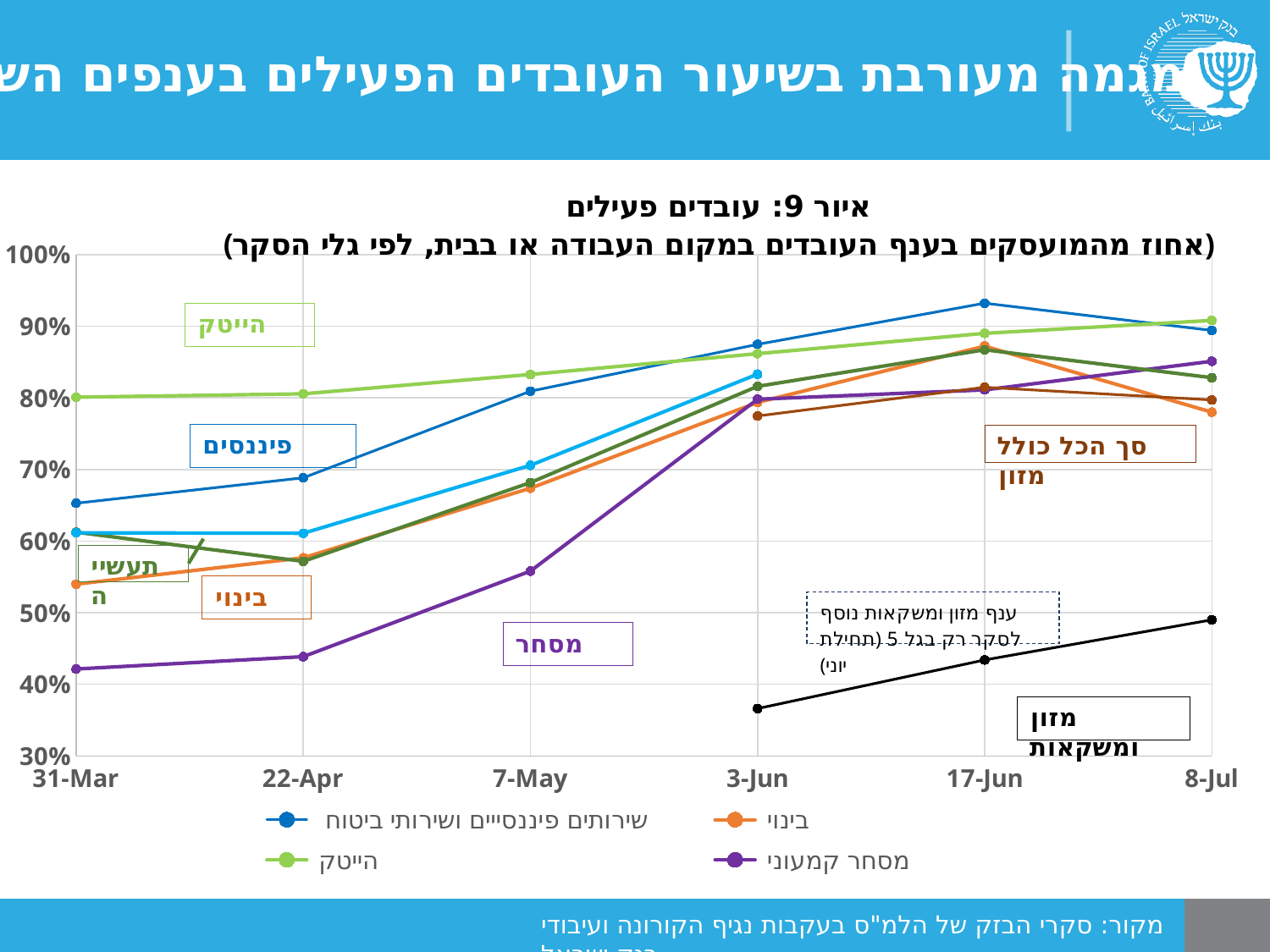
How many series does the legend list? 4 Which of the legend series has the lowest value at 31-Mar? מסחר קמעוני What kind of chart is shown on the slide? line chart Is the value for שירותים פיננסיים ושירותי ביטוח at 31-Mar greater or less than 60%? greater Is the value for בינוי at 31-Mar greater or less than 60%? less Is the value for מזון ומשקאות at 3-Jun greater or less than 40%? less What is the figure number given in the chart title? איור 9 Does the הייטק series rise or fall from 31-Mar to 8-Jul? rise How many survey dates are shown along the x axis? 6 Which series has the highest value at 17-Jun? שירותים פיננסיים ושירותי ביטוח